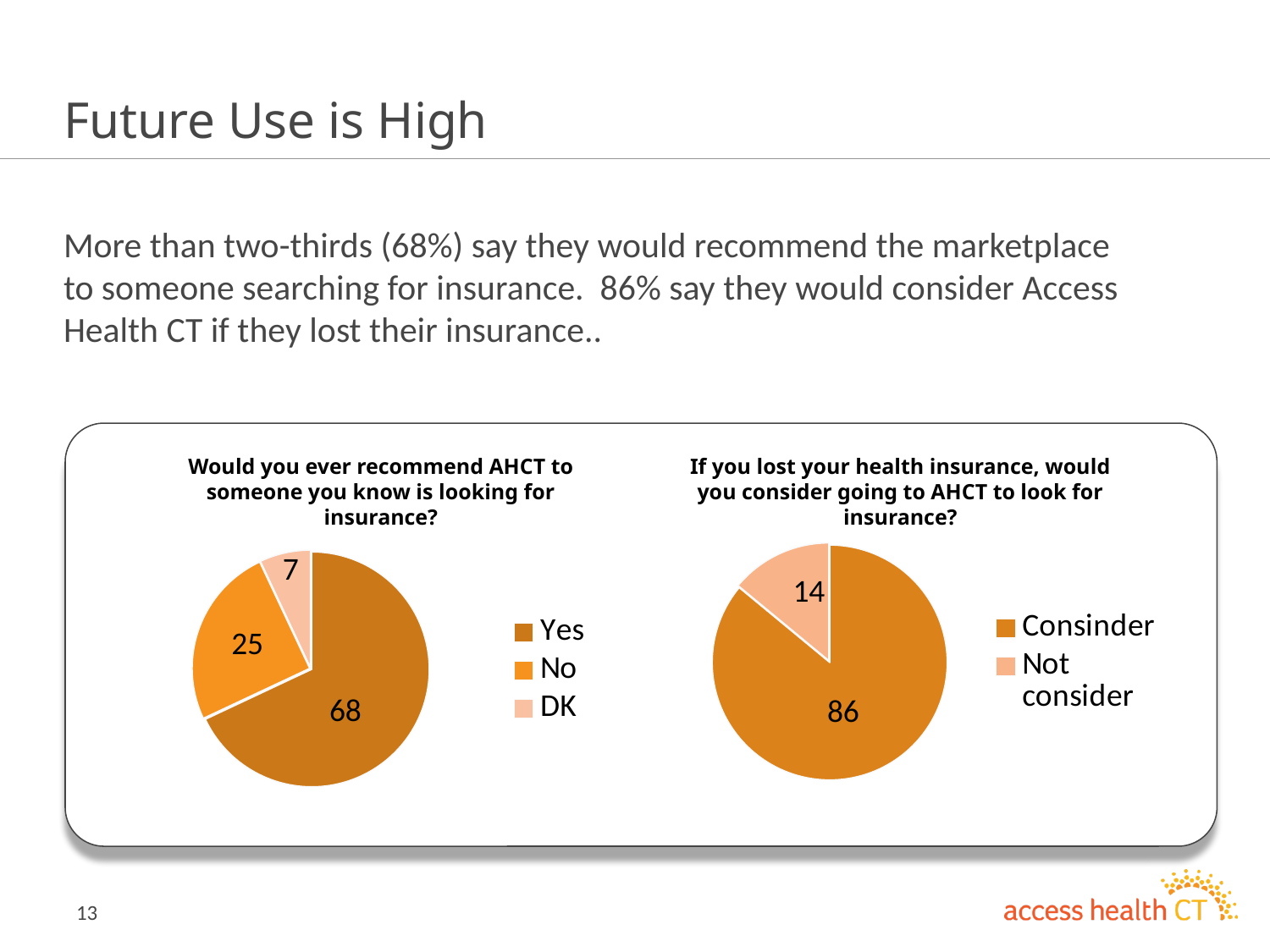
What type of chart is used on the right side of the slide? Pie chart In the left pie chart, which is larger, No or DK? No In the left pie chart, which category has the smallest slice? DK In the left pie chart, which category has the largest slice? Yes How many slices does the left pie chart have? 3 In the left pie chart ("Would you ever recommend AHCT..."), what is the value for DK? 7 In the left pie chart, what is the difference between the Yes and No values? 43 In the right pie chart ("If you lost your health insurance..."), what is the value for Not consider? 14 In the left pie chart ("Would you ever recommend AHCT..."), what is the value for No? 25 In the right pie chart, what is the difference between the Consider and Not consider values? 72 In the right pie chart ("If you lost your health insurance..."), what is the value for Consider? 86 In the left pie chart ("Would you ever recommend AHCT..."), what is the value for Yes? 68